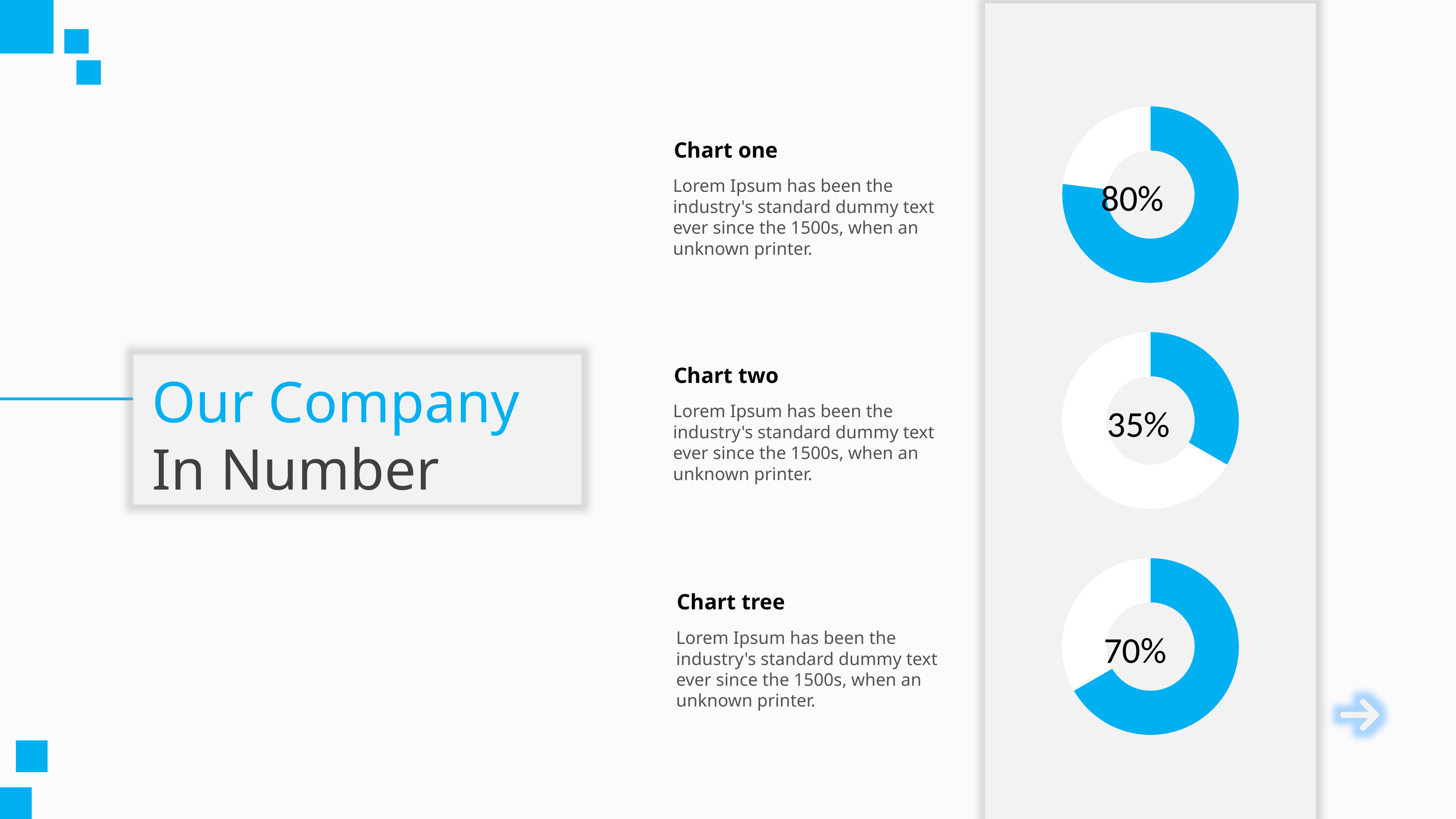
What kind of chart is used to display the percentages on the right side of the slide? Donut chart Which is larger, the value in the middle donut chart or the value in the bottom donut chart? The bottom donut chart (70%) What value is shown in the bottom donut chart (Chart tree)? 70% Which of the three donut charts shows the highest value? Chart one (80%) What is the title of the slide containing the donut charts? Our Company In Number What colour is the filled portion of each donut chart? Blue What is the difference between the value in the top donut chart and the value in the middle donut chart? 45% What is the difference between the value in the top donut chart and the value in the bottom donut chart? 10% What value is shown in the top donut chart (Chart one)? 80% How many donut charts are shown on the slide? 3 What value is shown in the middle donut chart (Chart two)? 35% Which of the three donut charts shows the lowest value? Chart two (35%)